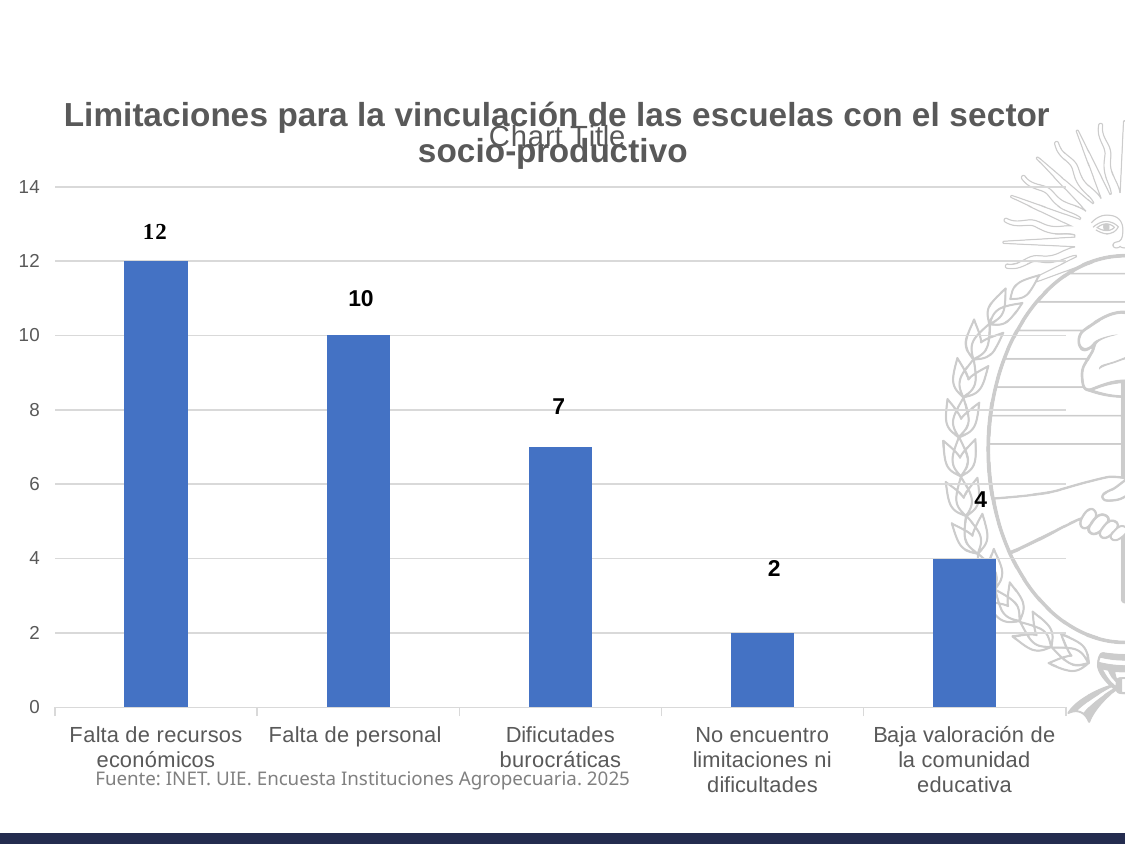
What is the value for "No encuentro limitaciones ni dificultades"? 2 What is the value for "Falta de recursos económicos"? 12 What is the difference between the values for "Falta de recursos económicos" and "Falta de personal"? 2 What source is cited below the chart? Fuente: INET. UIE. Encuesta Instituciones Agropecuaria. 2025 How many categories are shown on the x axis? 5 What kind of chart is shown on the slide? Bar chart Which category has the lowest value? No encuentro limitaciones ni dificultades What is the value for "Falta de personal"? 10 What is the value for "Baja valoración de la comunidad educativa"? 4 Which is larger, the value for "Dificutades burocráticas" or the value for "Baja valoración de la comunidad educativa"? Dificutades burocráticas Which category has the highest value? Falta de recursos económicos What is the value for "Dificutades burocráticas"? 7